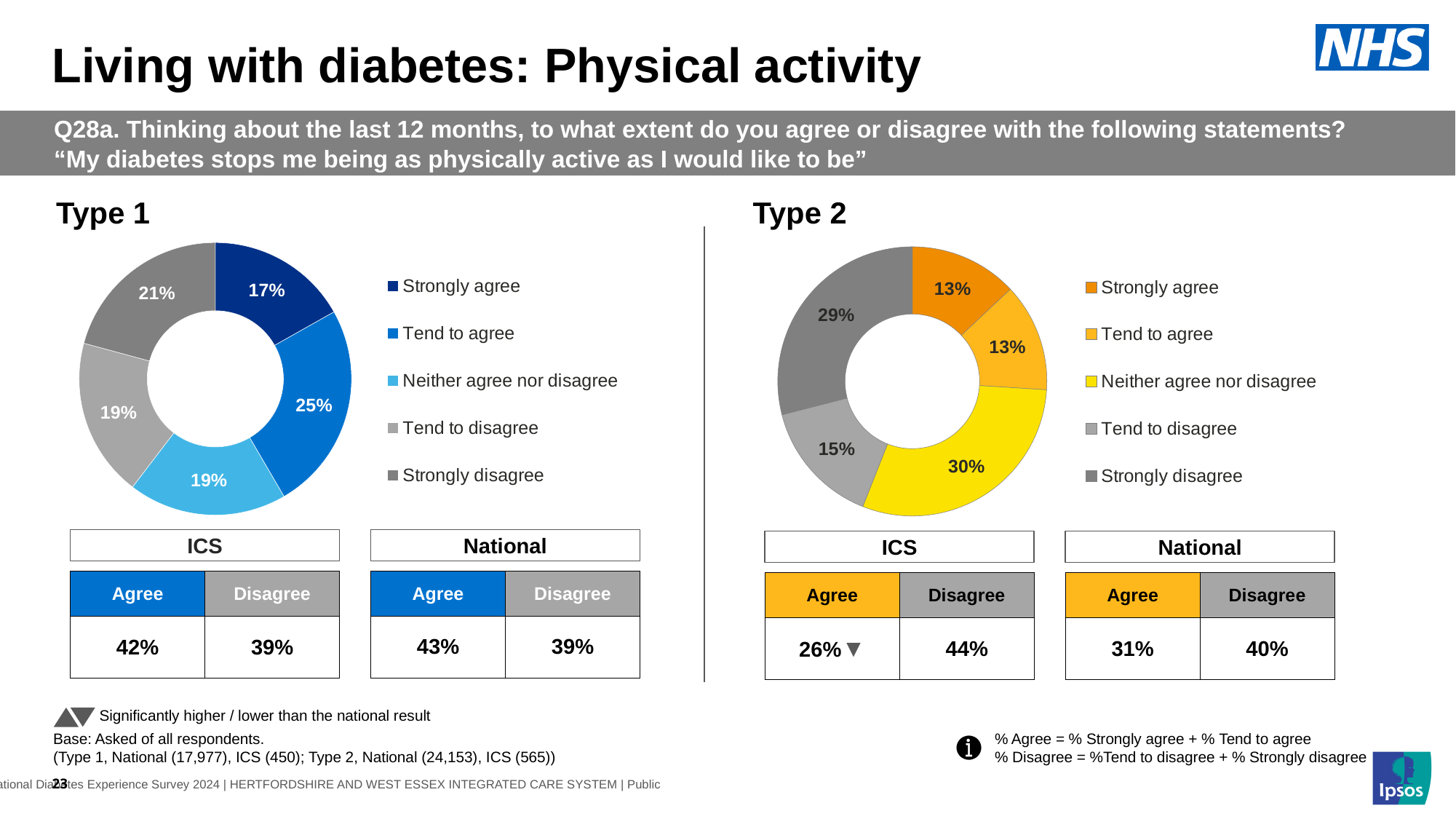
In the Type 2 chart, which category has the largest share? Neither agree nor disagree In the Type 1 chart, what percentage is shown for Strongly disagree? 21% In the Type 2 chart, what is the difference between the Strongly disagree and Tend to disagree percentages? 14 percentage points In the Type 2 chart, which is larger: Strongly disagree or Strongly agree? Strongly disagree In the Type 2 chart, what colour is the Neither agree nor disagree segment? Yellow How many categories does the legend of the Type 1 chart list? 5 In the Type 1 chart, which category has the largest share? Tend to agree In the Type 1 chart, what is the difference between the Tend to agree and Strongly agree percentages? 8 percentage points What kind of chart is used for Type 2? Donut (pie) chart In the Type 2 chart, what percentage is shown for Tend to disagree? 15% In the Type 2 chart, what percentage is shown for Neither agree nor disagree? 30% In the Type 1 chart, what percentage is shown for Tend to agree? 25%